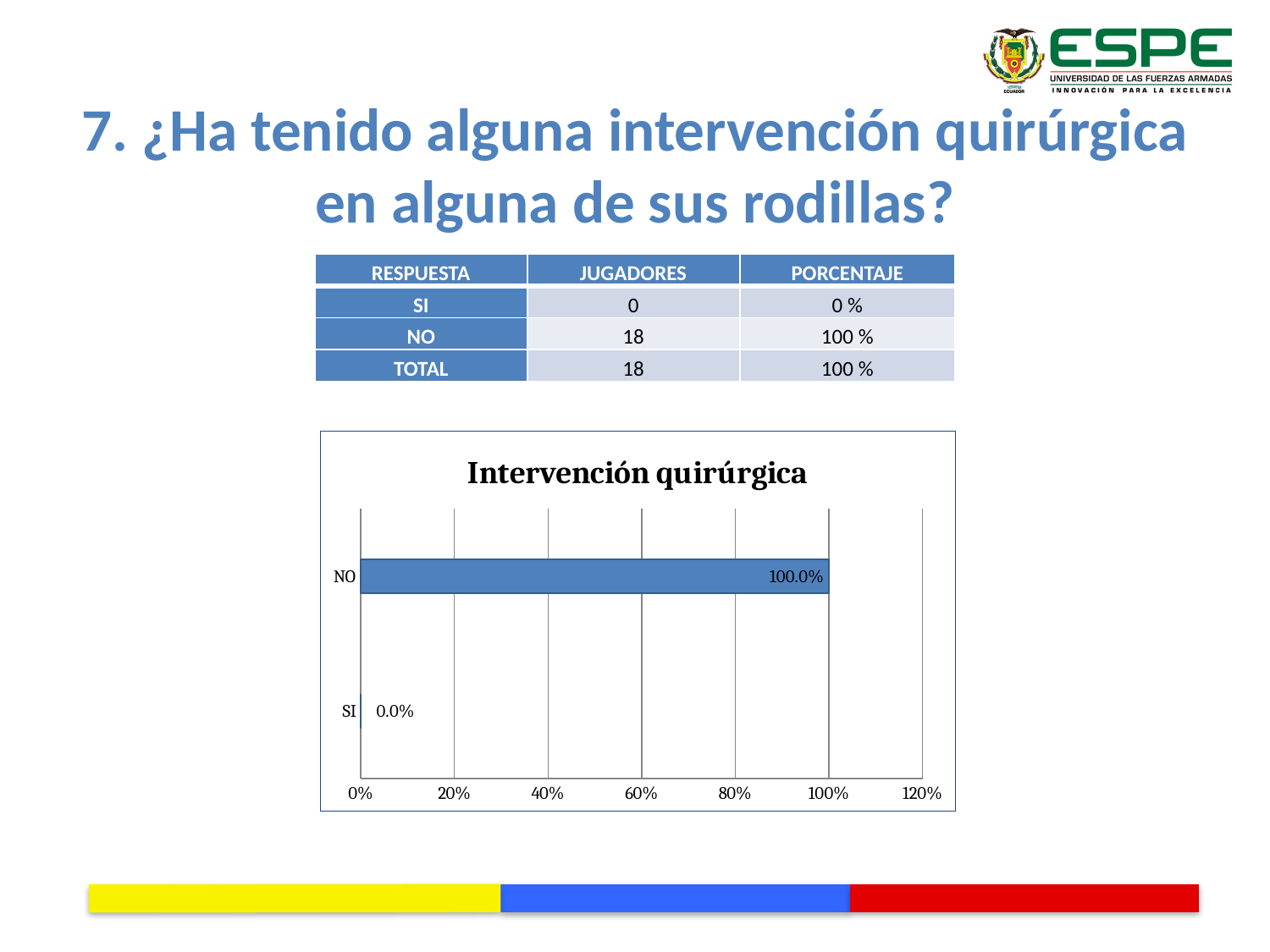
Which category has the highest value in the Intervención quirúrgica chart? NO Which is larger in the Intervención quirúrgica chart, the value for NO or the value for SI? NO What is the value for SI in the Intervención quirúrgica chart? 0.0% What is the title of the chart on the slide? Intervención quirúrgica What is the difference between the values for NO and SI in the Intervención quirúrgica chart? 100.0% What is the value for NO in the Intervención quirúrgica chart? 100.0% Which category has the lowest value in the Intervención quirúrgica chart? SI What kind of chart is the Intervención quirúrgica chart? bar chart How many categories are shown in the Intervención quirúrgica chart? 2 Is the value for NO in the Intervención quirúrgica chart greater or less than 80%? greater What is the highest tick value shown on the x axis of the Intervención quirúrgica chart? 120%